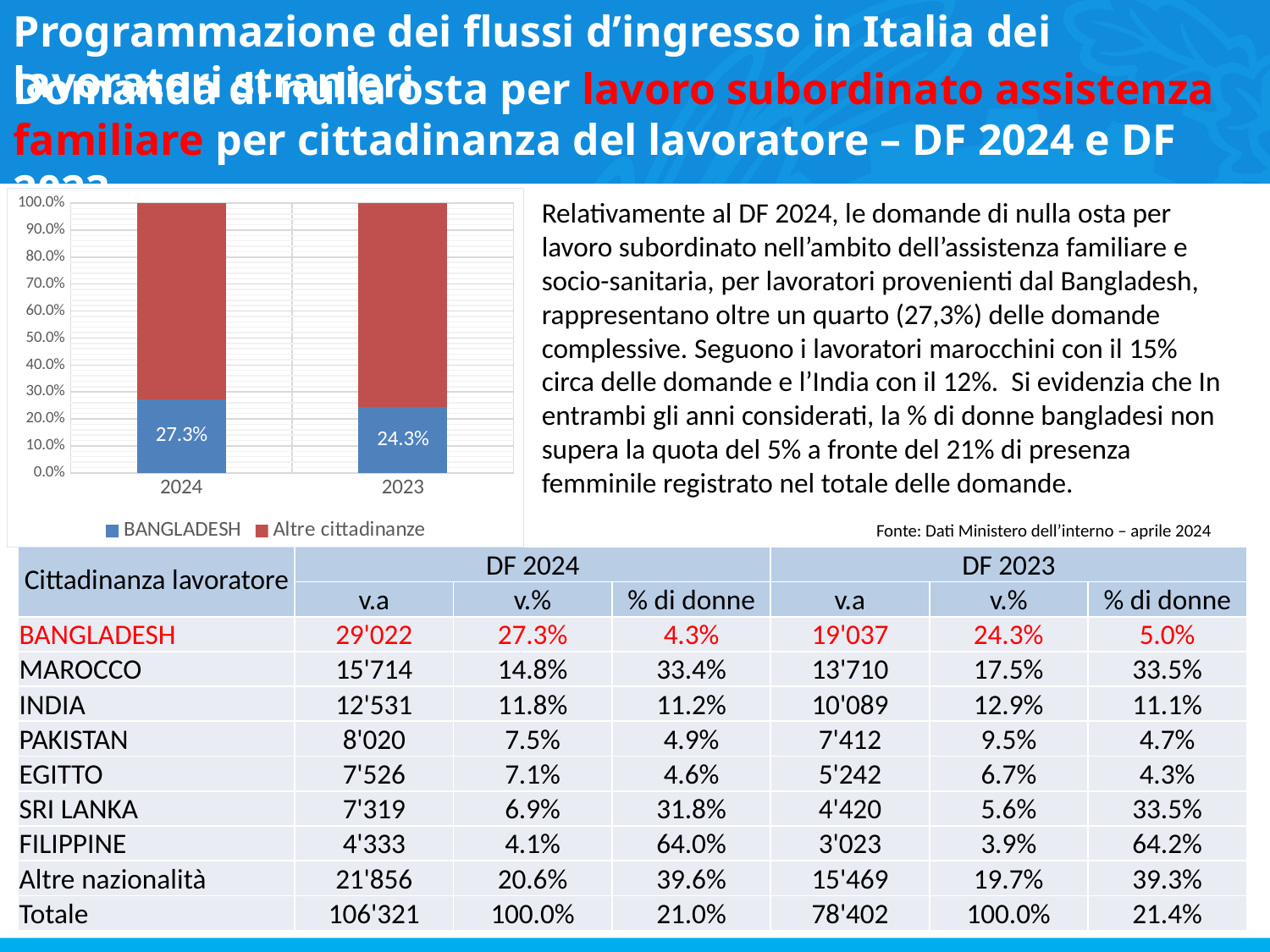
What is the value for BANGLADESH in 2024 in the stacked bar chart? 27.3% Does the BANGLADESH share rise or fall moving from 2024 to 2023 along the x axis? fall What is the total of the stacked bar for 2024? 100.0% What kind of chart is shown on the slide? Stacked bar chart Is the value for Altre cittadinanze in 2024 greater or less than 50.0%? greater Is the BANGLADESH value for 2024 greater or less than 30.0%? less What are the two entries in the chart legend? BANGLADESH and Altre cittadinanze What is the value for BANGLADESH in 2023 in the stacked bar chart? 24.3% How many categories (years) are shown on the x axis of the chart? 2 What is the difference between the BANGLADESH share in 2024 and in 2023 in the chart? 3.0% How many series does the chart legend list? 2 In the stacked bar chart, which year has the larger BANGLADESH share, 2024 or 2023? 2024